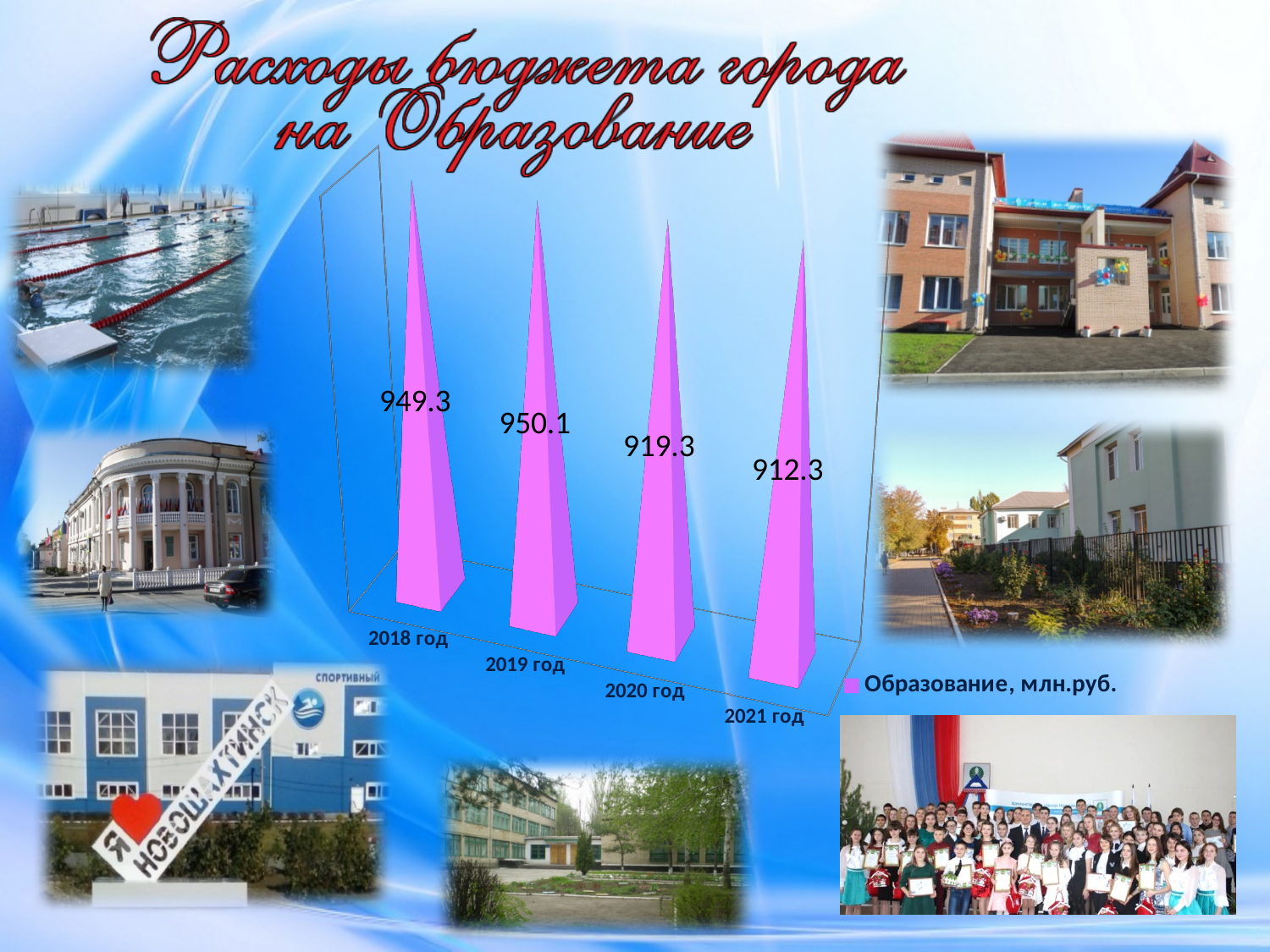
What kind of chart is shown on the slide? bar chart What is the legend entry of the chart? Образование, млн.руб. What is the difference between the values for 2019 год and 2021 год? 37.8 Which is larger, the value for 2020 год or the value for 2021 год? 2020 год What is the difference between the values for 2018 год and 2020 год? 30 What is the value for 2019 год? 950.1 What is the value for 2021 год? 912.3 How many years are shown on the chart? 4 What is the value for 2020 год? 919.3 Which year has the lowest value? 2021 год Which year has the highest value? 2019 год What is the value for 2018 год? 949.3